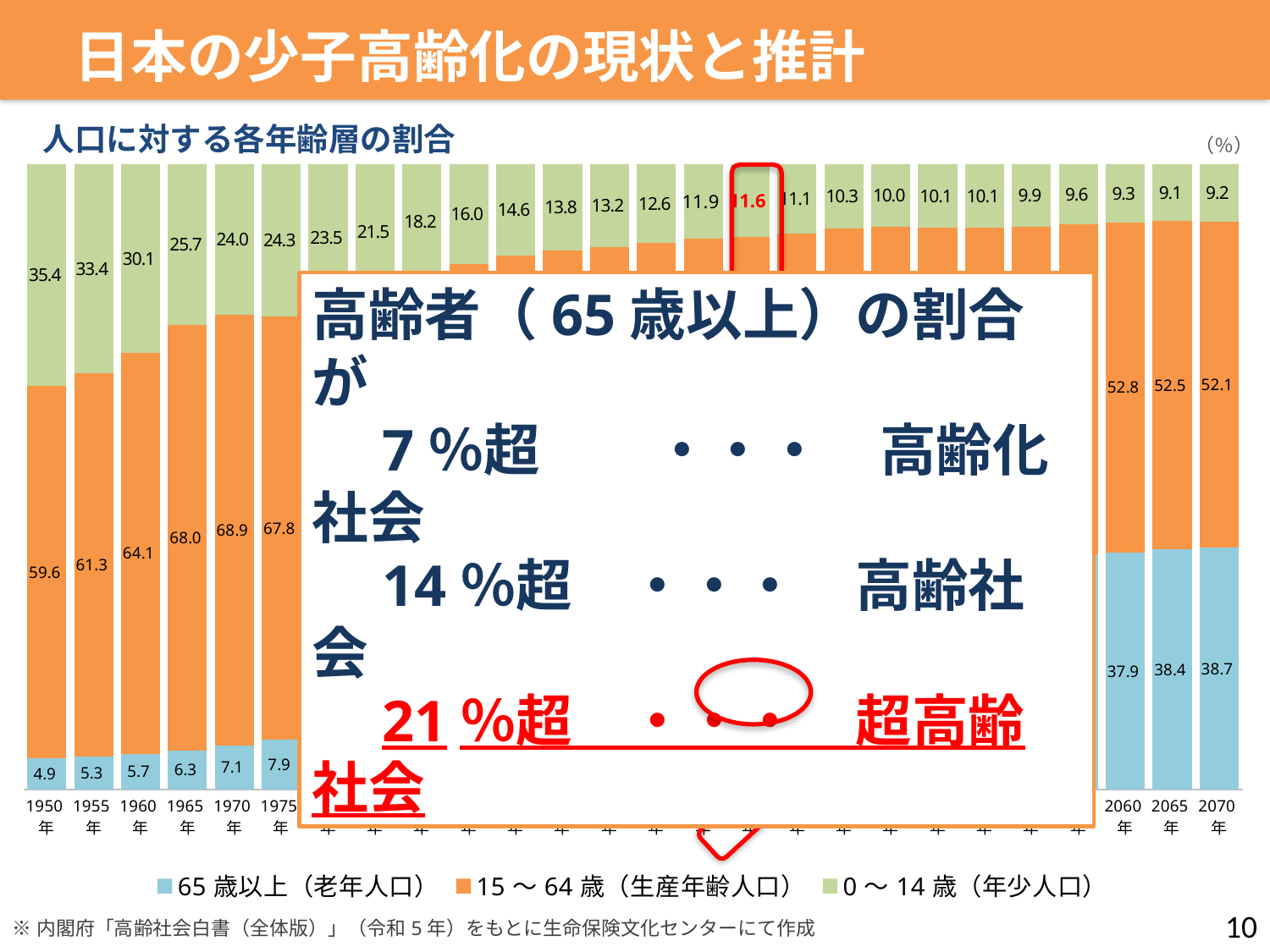
What is the value for the 0～14歳（年少人口） series in 1950年? 35.4 Among the years 1950年 to 1975年, which year has the highest 15～64歳（生産年齢人口） value? 1970年 What is the value for the 15～64歳（生産年齢人口） series in 2060年? 52.8 What is the total of the stacked bar for 1950年? 99.9 Does the 65歳以上（老年人口） value rise or fall from 1950年 to 1975年? Rise What is the difference between the 65歳以上（老年人口） value in 2070年 and in 1950年? 33.8 How many series does the legend list? 3 What is the value for the 15～64歳（生産年齢人口） series in 1970年? 68.9 What is the title of the chart? 人口に対する各年齢層の割合 What kind of chart is shown on the slide? Stacked bar chart What is the value for the 65歳以上（老年人口） series in 2070年? 38.7 Which year has the larger 0～14歳（年少人口） value, 1950年 or 2070年? 1950年